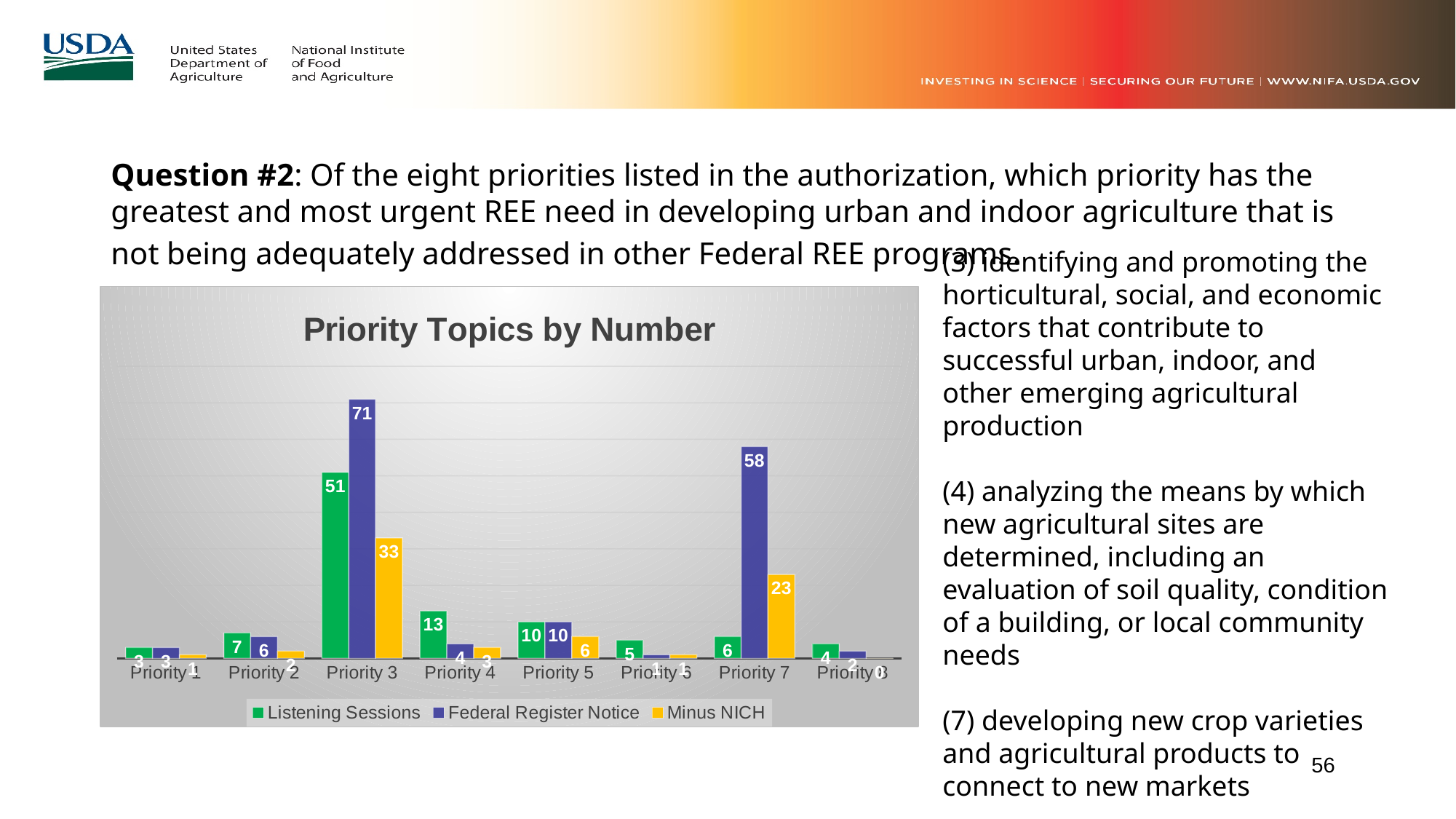
Which priority has the highest Federal Register Notice value? Priority 3 What is the Listening Sessions value for Priority 4? 13 Which priority has the highest Listening Sessions value? Priority 3 How many series does the chart's legend list? 3 How many priority categories are shown on the x axis? 8 What is the Minus NICH value for Priority 7? 23 What is the Minus NICH value for Priority 5? 6 What type of chart is shown on the slide? bar chart For Priority 3, what is the difference between the Federal Register Notice value and the Listening Sessions value? 20 What is the title of the chart? Priority Topics by Number For Priority 7, which is larger: the Federal Register Notice value or the Listening Sessions value? Federal Register Notice What is the Federal Register Notice value for Priority 3? 71